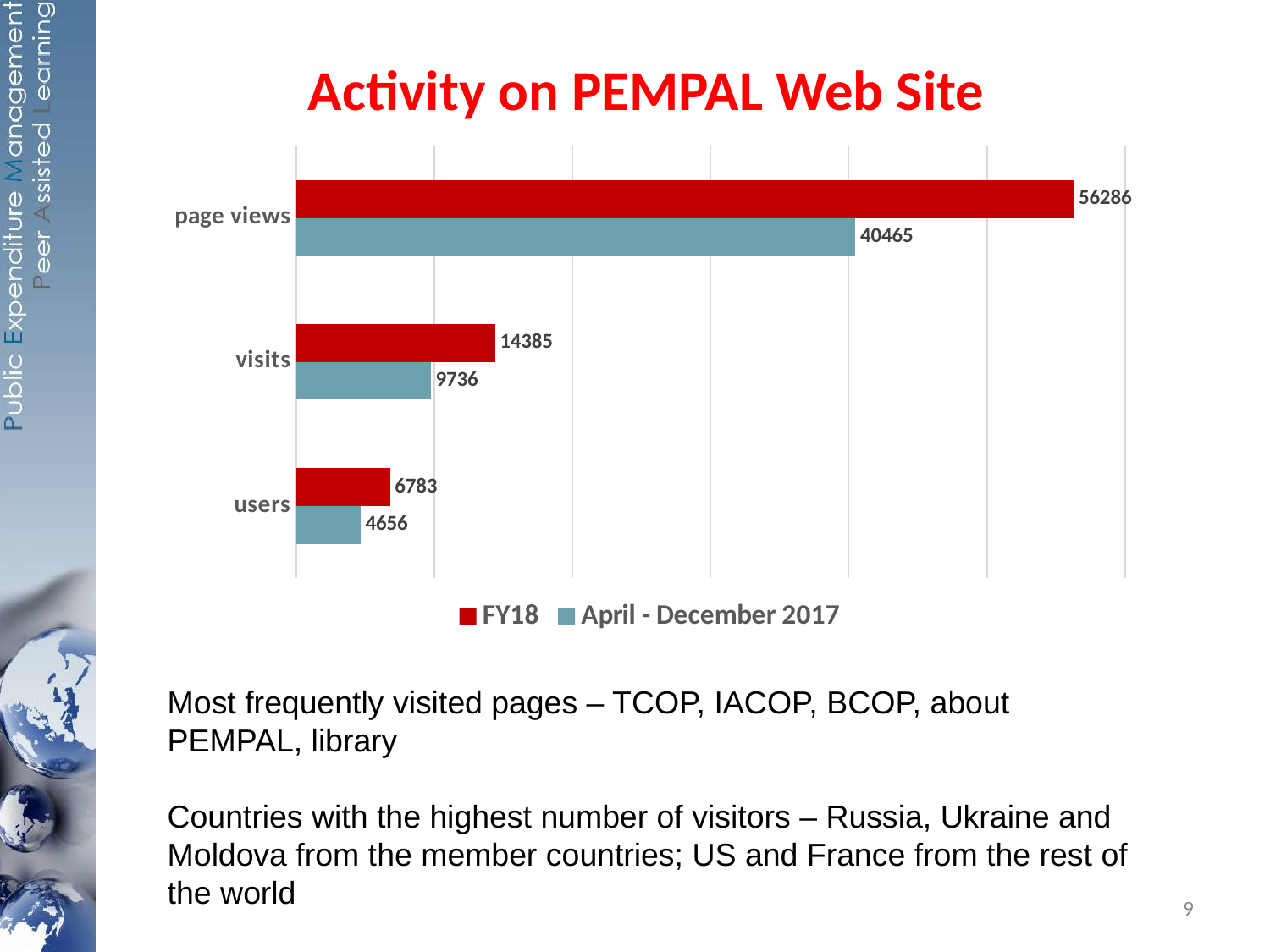
Which is larger for page views: FY18 or April - December 2017? FY18 What is the difference between the FY18 and April - December 2017 values for visits? 4649 How many series does the legend list? 2 Which category has the lowest April - December 2017 value? users What is the FY18 value for page views? 56286 What is the April - December 2017 value for visits? 9736 What kind of chart is shown on the slide? bar chart How many categories are shown on the chart? 3 What is the FY18 value for users? 6783 Which category has the highest FY18 value? page views What is the difference between the FY18 and April - December 2017 values for users? 2127 What is the April - December 2017 value for page views? 40465